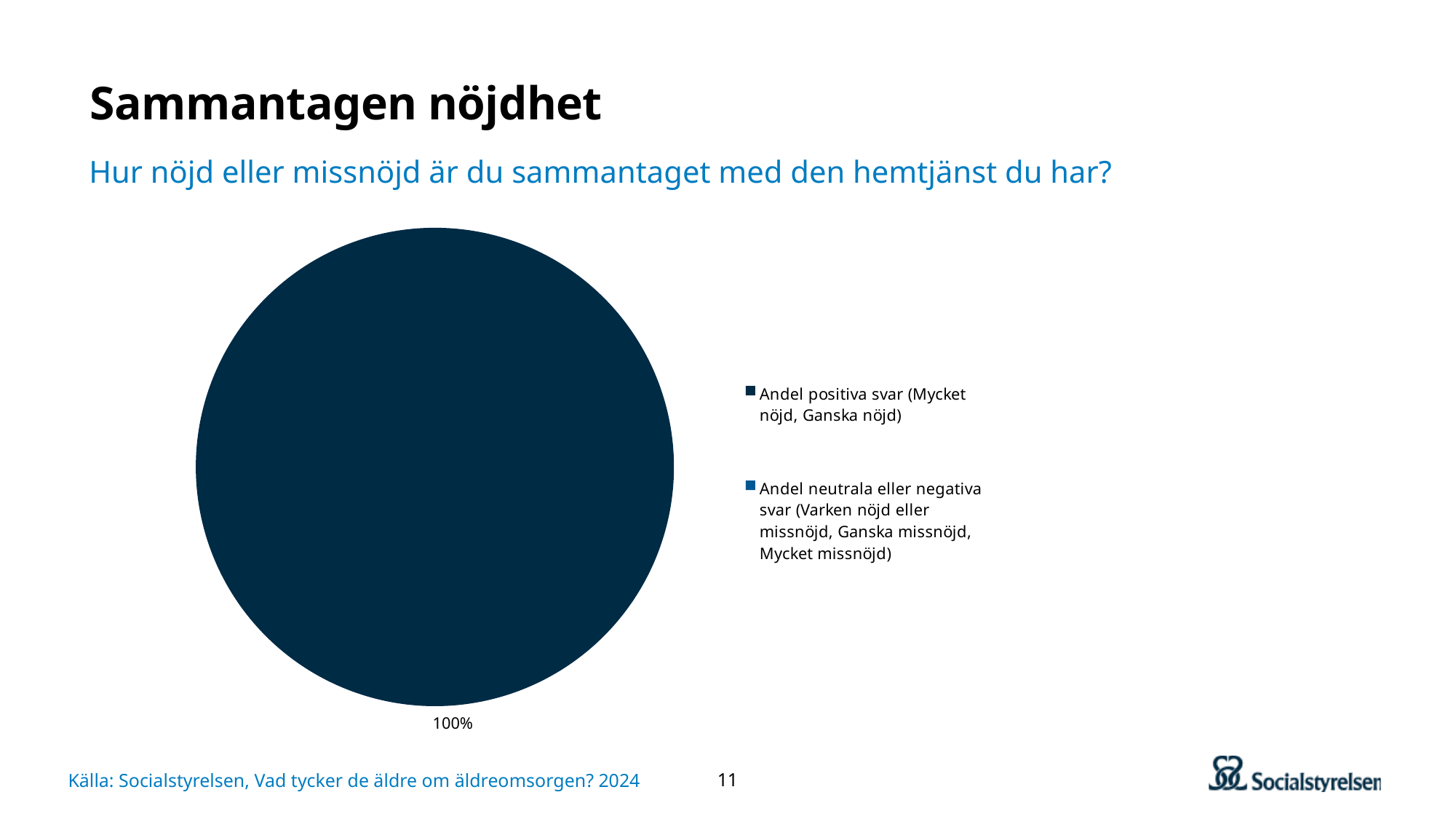
What percentage is shown for 'Andel positiva svar (Mycket nöjd, Ganska nöjd)'? 100% What is the title of the slide containing the chart? Sammantagen nöjdhet How many slices are visibly drawn in the pie? 1 What share of the pie does the 'Andel positiva svar' slice take up? 100% What is the only data label printed on the pie chart? 100% What kind of chart is shown on the slide? Pie chart How many entries does the legend list? 2 Which is larger: the share of 'Andel positiva svar' or the share of 'Andel neutrala eller negativa svar'? Andel positiva svar Which category takes up the largest share of the pie? Andel positiva svar (Mycket nöjd, Ganska nöjd) What question is the chart answering, as shown in the subtitle? Hur nöjd eller missnöjd är du sammantaget med den hemtjänst du har?